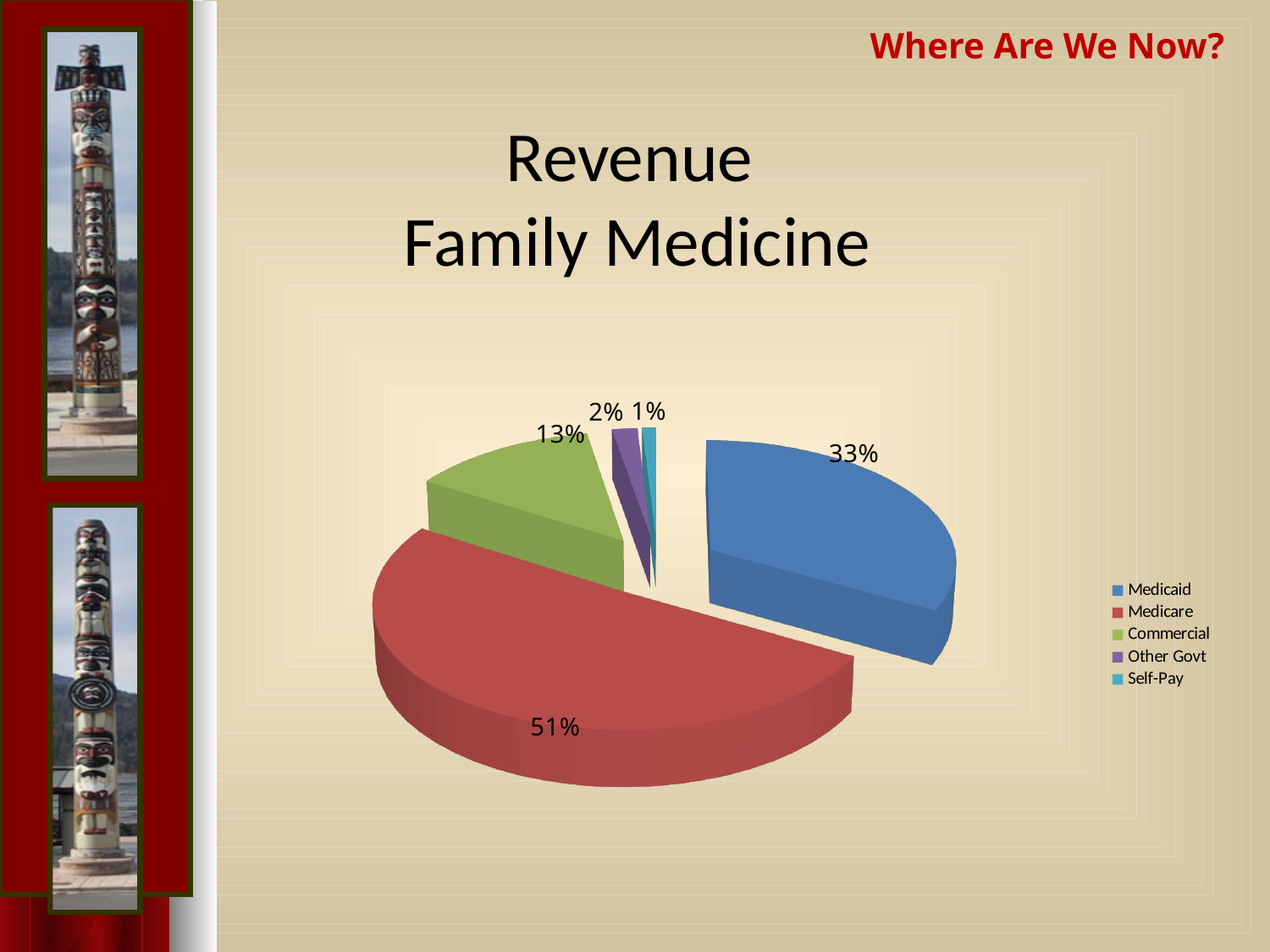
What percentage of revenue is labelled for Commercial? 13% How many slices does the pie chart have? 5 What is the title of the chart? Revenue Family Medicine Which payer accounts for the smallest share of Family Medicine revenue? Self-Pay Which is larger, the Commercial share or the Medicaid share? Medicaid What percentage of revenue is labelled for Self-Pay? 1% What share of Family Medicine revenue comes from Medicaid? 33% What type of chart is shown on the slide? Pie chart Which payer accounts for the largest share of Family Medicine revenue? Medicare What share of Family Medicine revenue comes from Medicare? 51% What percentage of revenue is labelled for Other Govt? 2% How many percentage points larger is the Medicare share than the Medicaid share? 18